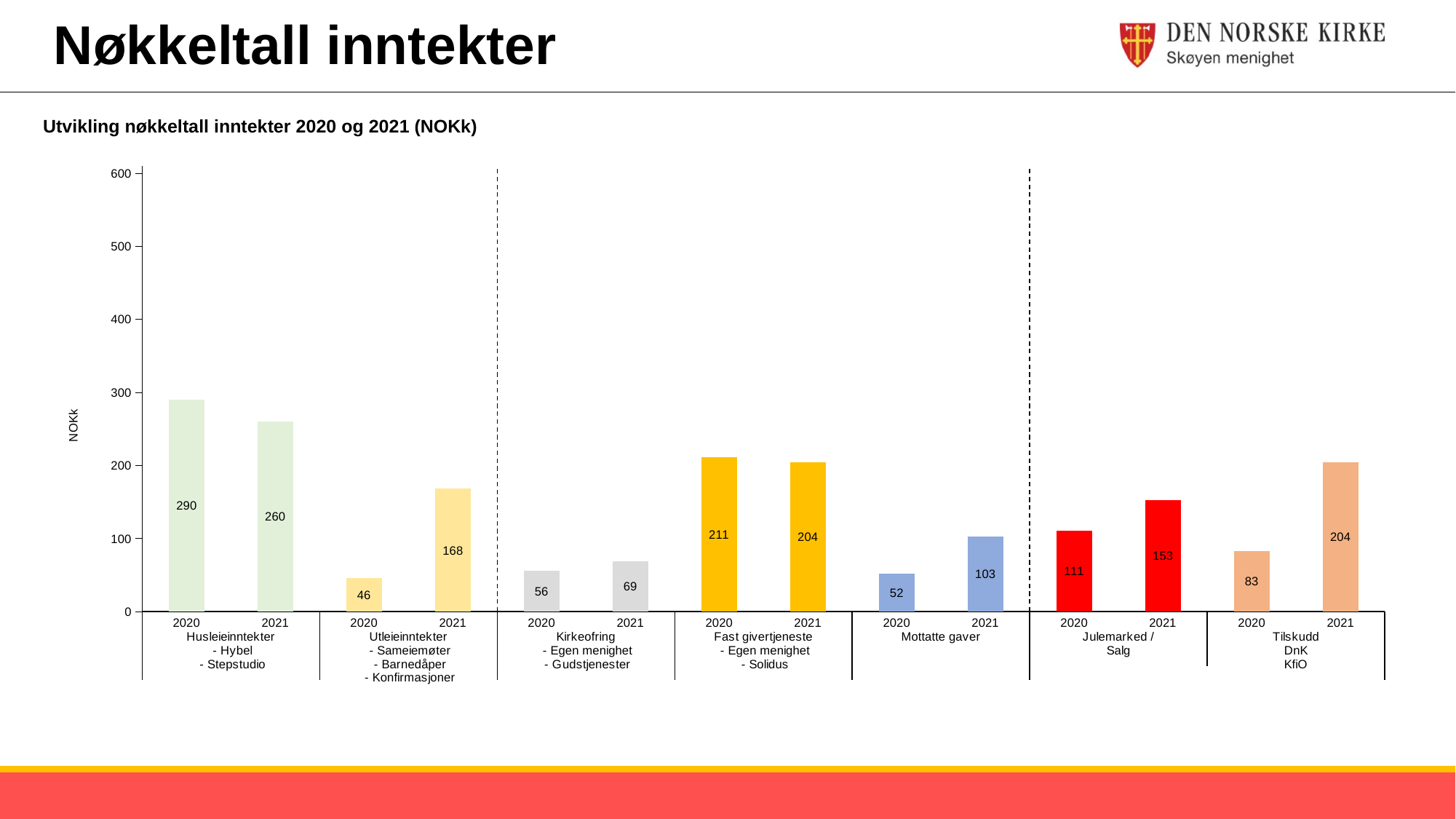
What is the value for Husleieinntekter in 2020? 290 What is the value for Utleieinntekter in 2021? 168 Which bar has the highest value on the chart? Husleieinntekter 2020 What is the value for Mottatte gaver in 2021? 103 How many bars are plotted on the chart? 14 What is the value for Tilskudd in 2020? 83 Is the value for Kirkeofring in 2021 greater or less than 100? less What kind of chart is shown on the slide? bar chart What is the title of the chart? Utvikling nøkkeltall inntekter 2020 og 2021 (NOKk) Which is larger, Fast givertjeneste in 2020 or in 2021? 2020 Which bar has the lowest value on the chart? Utleieinntekter 2020 What is the difference between the 2021 and 2020 values for Julemarked / Salg? 42